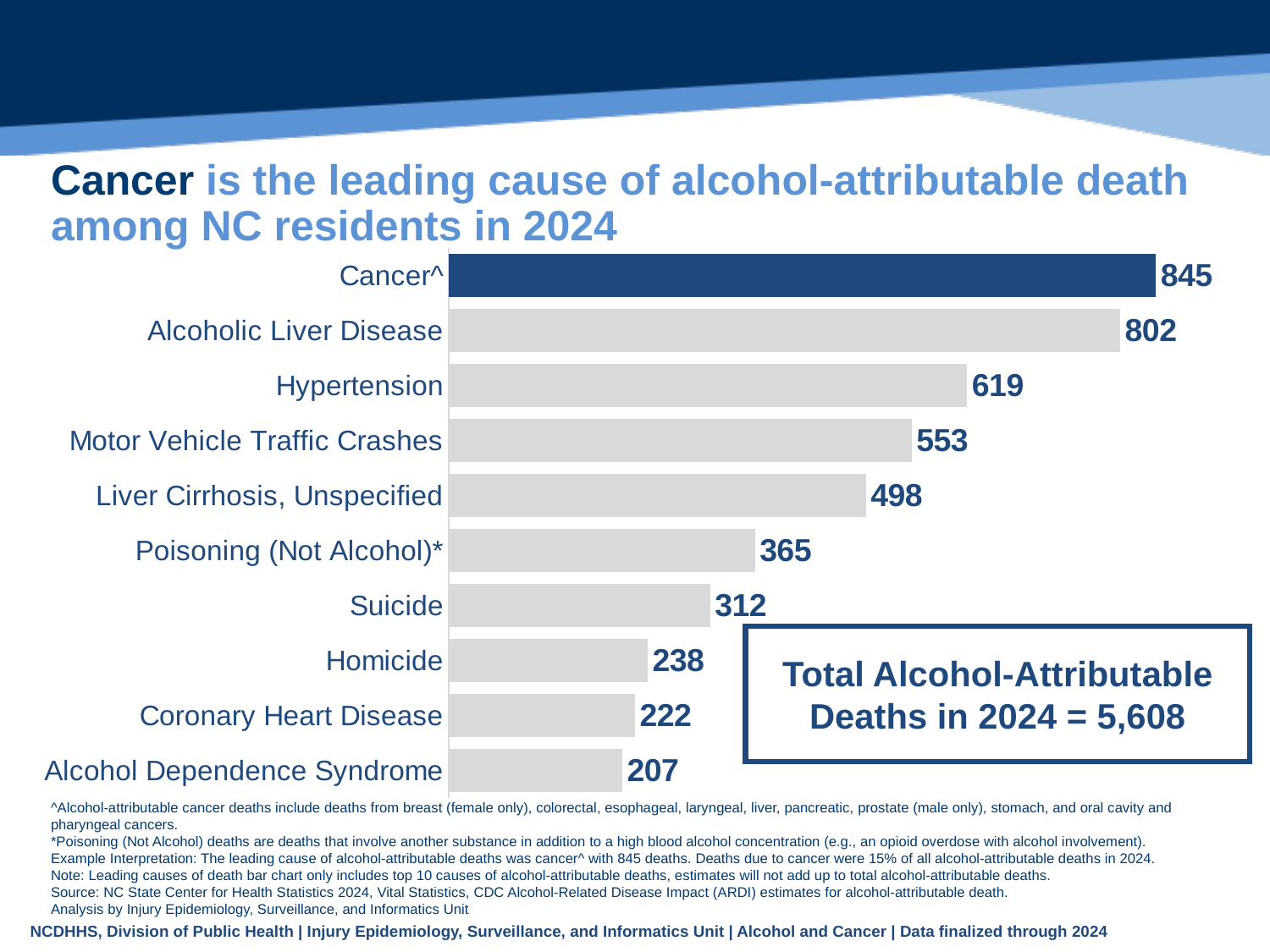
What is the difference between the values for Cancer^ and Alcoholic Liver Disease? 43 Which is larger, the value for Coronary Heart Disease or the value for Alcohol Dependence Syndrome? Coronary Heart Disease What kind of chart is shown on the slide? Bar chart Which is larger, the value for Suicide or the value for Homicide? Suicide Which cause of death has the lowest value on the chart? Alcohol Dependence Syndrome How many alcohol-attributable deaths are shown for Cancer^? 845 Which cause of death has the highest value on the chart? Cancer^ What is the value for Hypertension? 619 What total number of alcohol-attributable deaths in 2024 is stated in the box on the chart? 5,608 How many causes of death are shown on the chart? 10 What is the value for Poisoning (Not Alcohol)*? 365 What is the difference between the values for Motor Vehicle Traffic Crashes and Liver Cirrhosis, Unspecified? 55